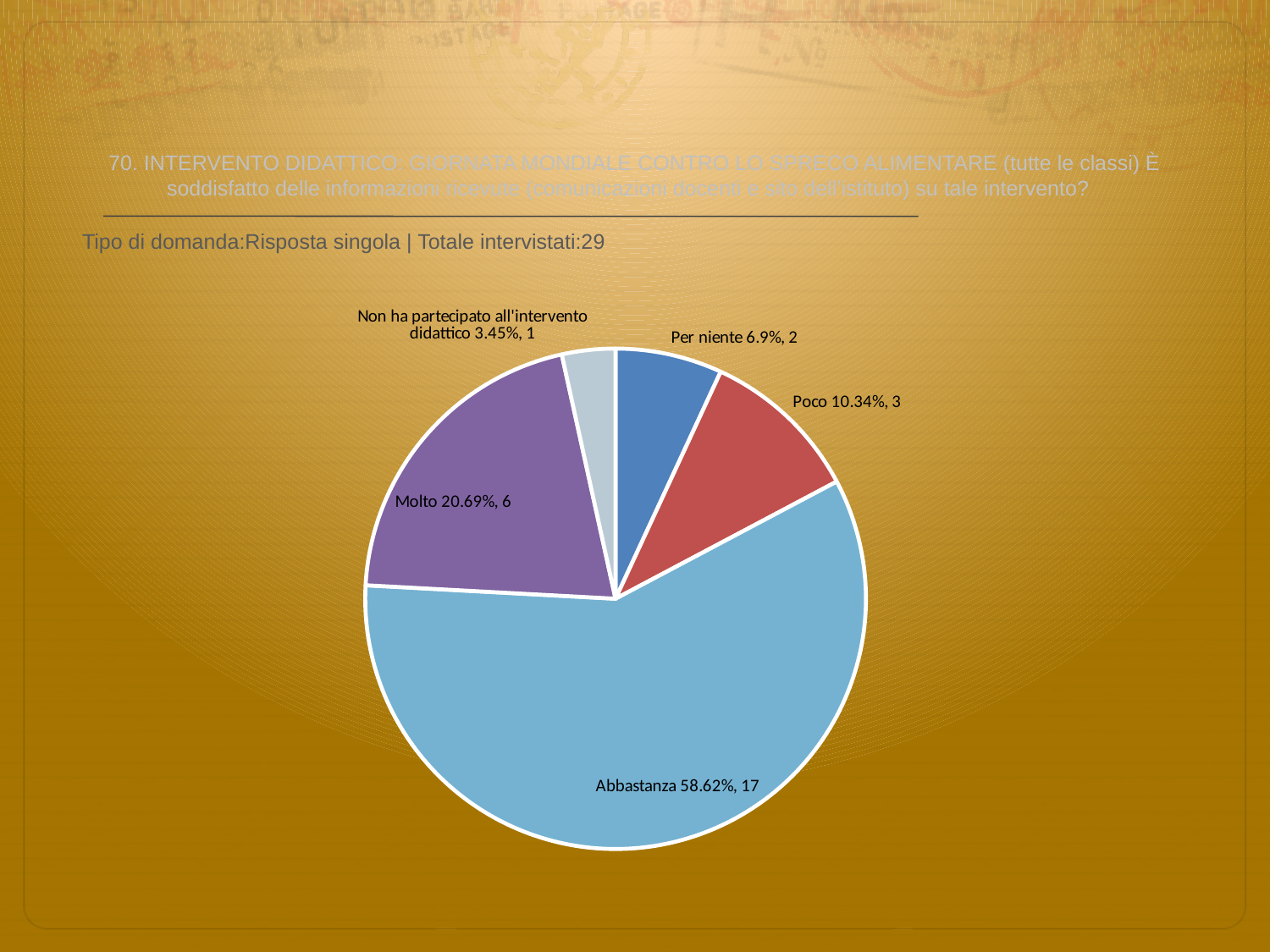
Which category has the largest slice of the pie? Abbastanza What percentage share does the 'Poco' slice have? 10.34% How many respondents answered 'Molto'? 6 What percentage share does the 'Abbastanza' slice have? 58.62% What colour is the 'Molto' slice? purple What is the total number of respondents stated on the slide? 29 How many slices does the pie chart have? 5 Which has more respondents, 'Poco' or 'Per niente'? Poco What is the difference in respondent count between 'Abbastanza' and 'Molto'? 11 Which category has the smallest slice of the pie? Non ha partecipato all'intervento didattico How many respondents answered 'Per niente'? 2 What kind of chart is shown on the slide? pie chart